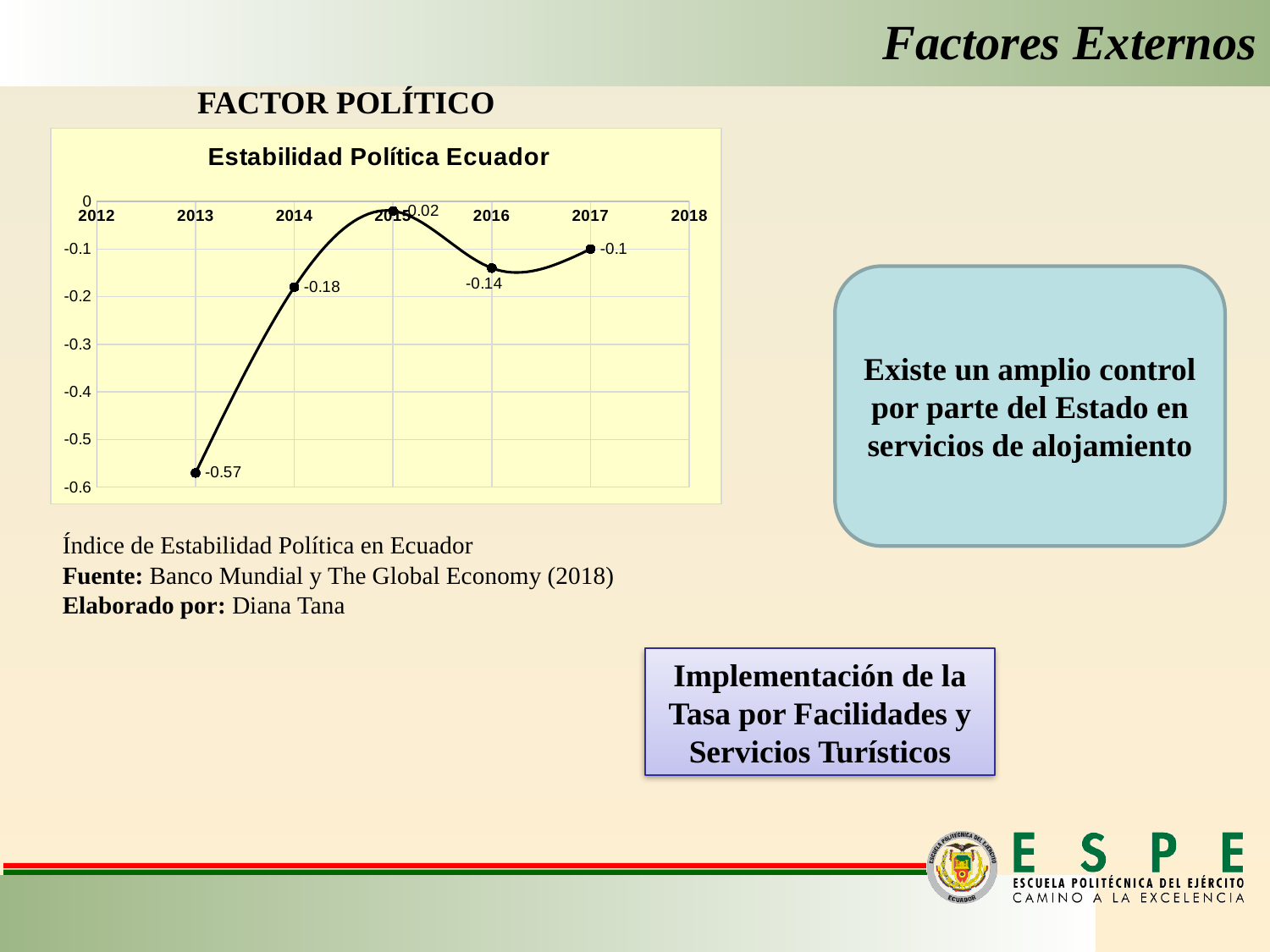
Which year has the lowest value? 2013 What is the value for 2017? -0.1 Which year has the highest value? 2015 What is the value for 2016? -0.14 What is the value for 2014? -0.18 How many data points are plotted on the line? 5 What is the title of the chart? Estabilidad Política Ecuador What is the value for 2013? -0.57 What kind of chart is shown on the slide? line chart Which is larger, the value for 2016 or the value for 2017? 2017 Does the value rise or fall from 2013 to 2015? rise What is the difference between the values for 2014 and 2013? 0.39